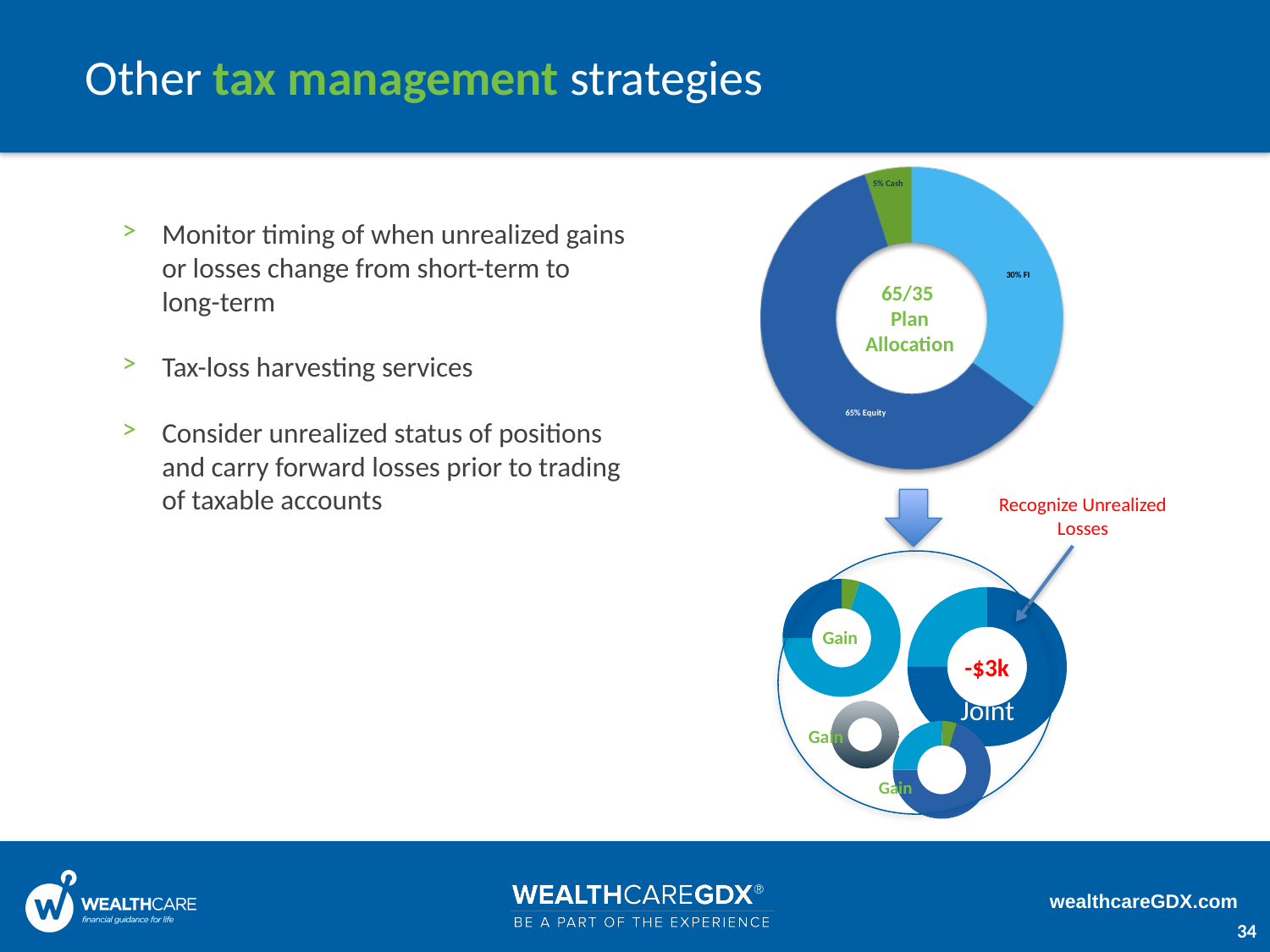
In the 65/35 Plan Allocation chart, which category has the smallest share? Cash In the 65/35 Plan Allocation chart, how many percentage points larger is Equity than FI? 35 In the 65/35 Plan Allocation chart, which category has the largest share? Equity In the smaller chart labelled Joint at the bottom right, what value is printed in its centre? -$3k In the 65/35 Plan Allocation chart, what share is allocated to FI? 30% In the 65/35 Plan Allocation chart, what share is allocated to Equity? 65% In the 65/35 Plan Allocation chart, how many percentage points larger is FI than Cash? 25 What is the title shown in the centre of the large doughnut chart at the top right? 65/35 Plan Allocation In the 65/35 Plan Allocation chart, which is larger, the FI share or the Cash share? FI What kind of chart is the 65/35 Plan Allocation chart? Doughnut (pie) chart How many categories are shown in the 65/35 Plan Allocation chart? 3 In the 65/35 Plan Allocation chart, what share is allocated to Cash? 5%